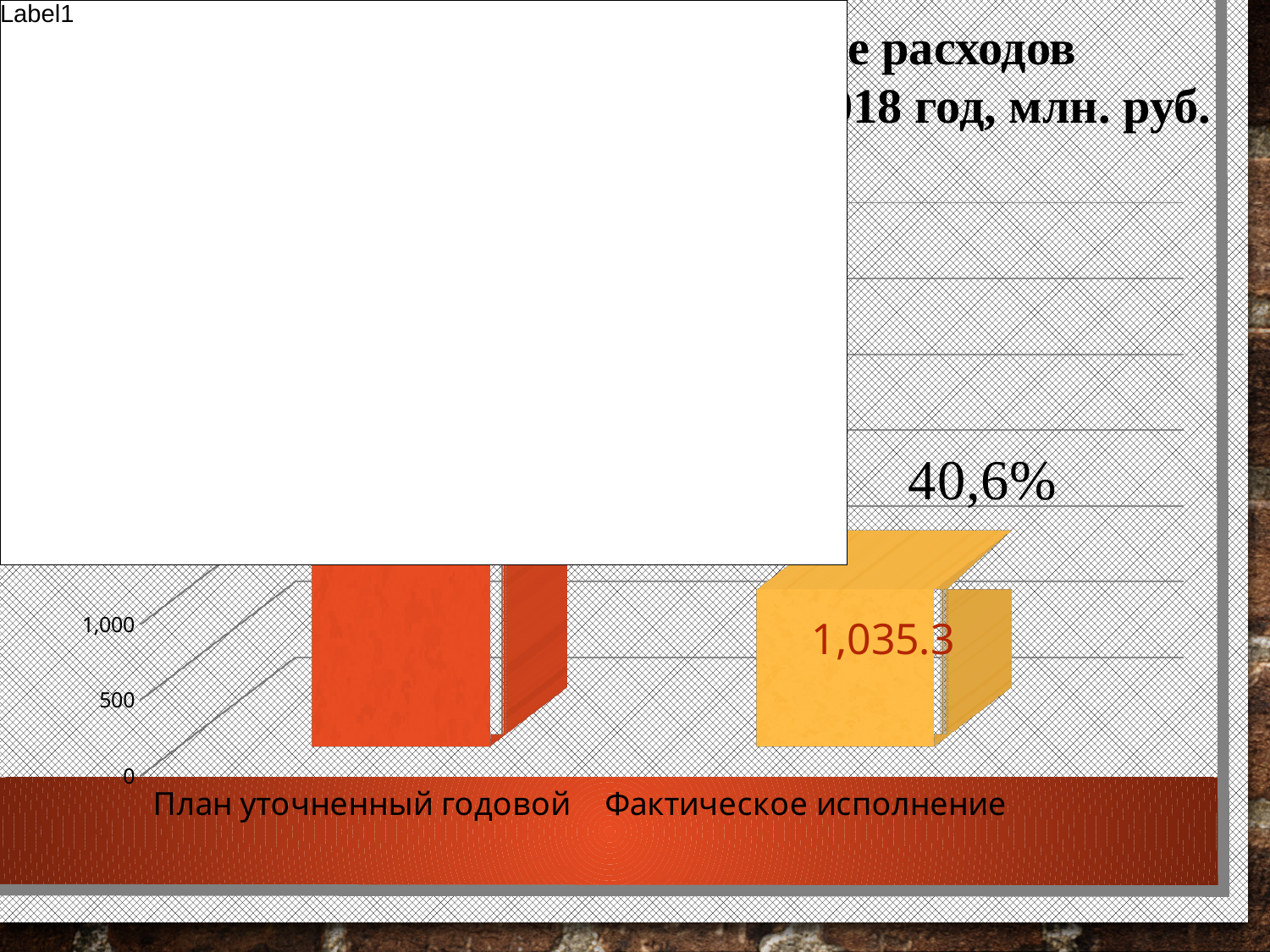
Is the value for Фактическое исполнение greater or less than 500? greater How many categories are shown on the x axis? 2 Do the values fall or rise from План уточненный годовой to Фактическое исполнение? fall What kind of chart is shown on the slide? bar chart Is the value for План уточненный годовой greater or less than 1,000? greater What is the value shown for Фактическое исполнение? 1,035.3 Which category has the highest value? План уточненный годовой What colour is the bar for Фактическое исполнение? yellow Which category has the taller bar, План уточненный годовой or Фактическое исполнение? План уточненный годовой Which category has the lowest value? Фактическое исполнение What percentage label is shown above the Фактическое исполнение bar? 40,6%